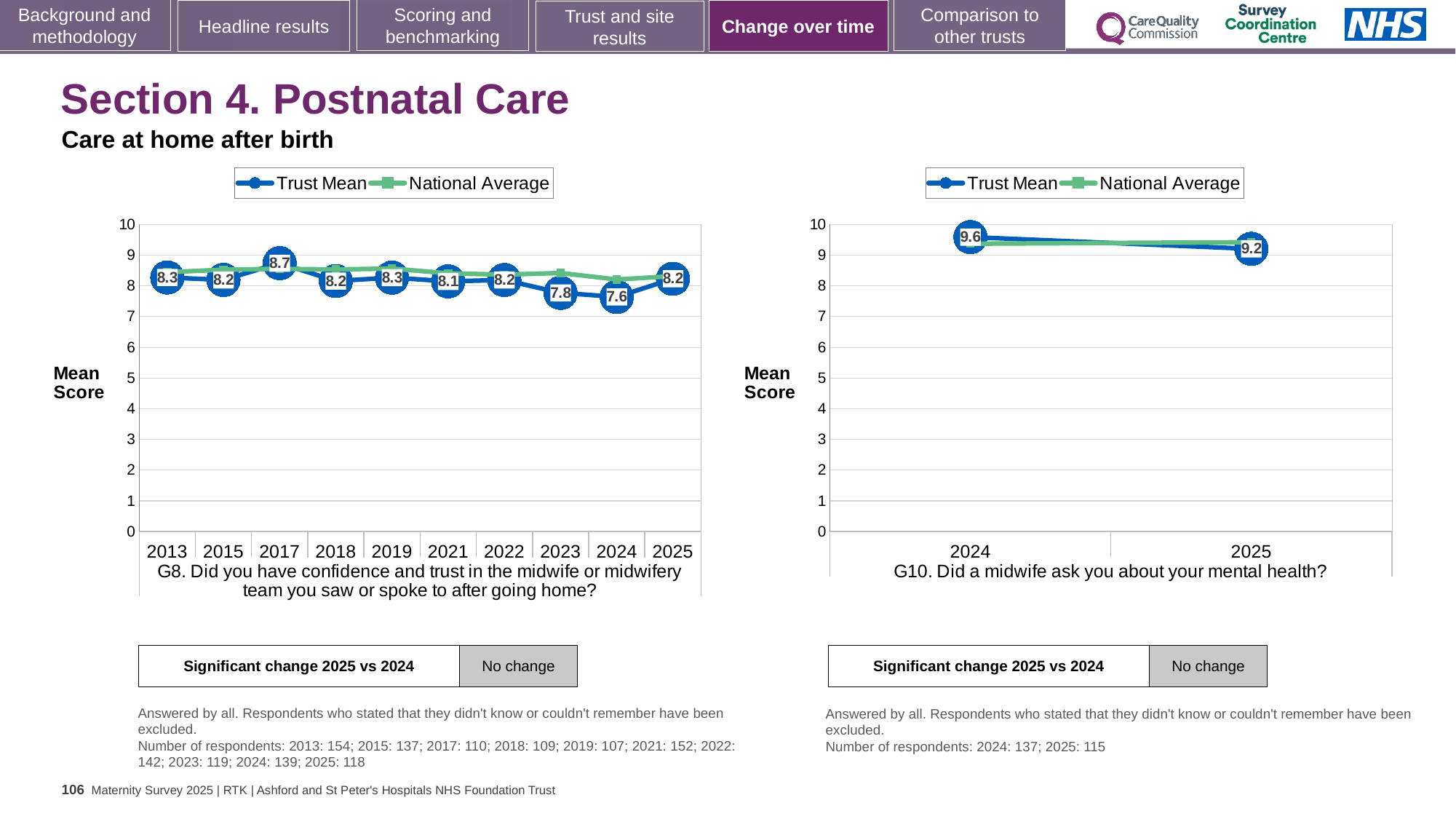
In the G8 chart (left), which year has the lowest Trust Mean score? 2024 In the G10 chart (right), does the Trust Mean rise or fall from 2024 to 2025? fall In the G10 chart (right), how many series does the legend list? 2 In the G8 chart (left), what is the Trust Mean score for 2024? 7.6 In the G10 chart (right), what is the Trust Mean score for 2025? 9.2 In the G8 chart (left), what is the Trust Mean score for 2017? 8.7 What kind of chart is the G8 chart on the left? line chart In the G8 chart (left), which year has the highest Trust Mean score? 2017 In the G10 chart (right), what is the Trust Mean score for 2024? 9.6 In the G8 chart (left), what is the Trust Mean score for 2025? 8.2 In the G8 chart (left), what is the difference between the Trust Mean scores for 2017 and 2024? 1.1 In the G8 chart (left), how many years are shown on the x axis? 10